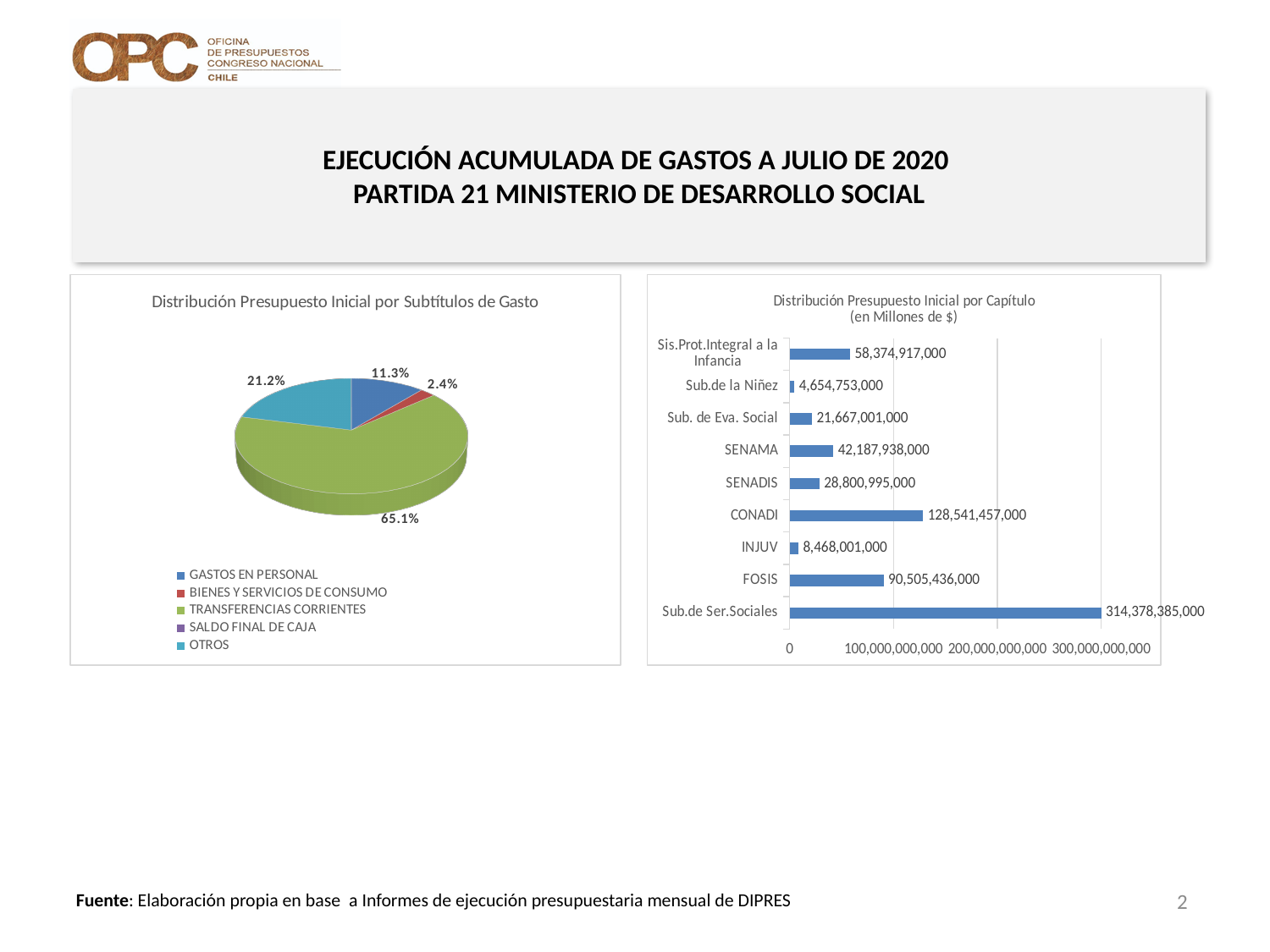
In the chart 'Distribución Presupuesto Inicial por Capítulo', what is the value for FOSIS? 90,505,436,000 In the pie chart 'Distribución Presupuesto Inicial por Subtítulos de Gasto', what share does TRANSFERENCIAS CORRIENTES have? 65.1% In the chart 'Distribución Presupuesto Inicial por Capítulo', which category has the lowest value? Sub.de la Niñez In the chart 'Distribución Presupuesto Inicial por Capítulo', which is larger, the value for INJUV or the value for Sub. de Eva. Social? Sub. de Eva. Social In the chart 'Distribución Presupuesto Inicial por Capítulo', what is the value for CONADI? 128,541,457,000 How many categories are shown in the chart 'Distribución Presupuesto Inicial por Capítulo'? 9 In the chart 'Distribución Presupuesto Inicial por Capítulo', what is the difference between the values for SENAMA and SENADIS? 13,386,943,000 In the pie chart 'Distribución Presupuesto Inicial por Subtítulos de Gasto', what share does GASTOS EN PERSONAL have? 11.3% What kind of chart is 'Distribución Presupuesto Inicial por Capítulo'? bar chart In the chart 'Distribución Presupuesto Inicial por Capítulo', which category has the highest value? Sub.de Ser.Sociales How many entries does the legend of the pie chart 'Distribución Presupuesto Inicial por Subtítulos de Gasto' list? 5 In the chart 'Distribución Presupuesto Inicial por Capítulo', is the value for Sub.de Ser.Sociales greater or less than 300,000,000,000? greater